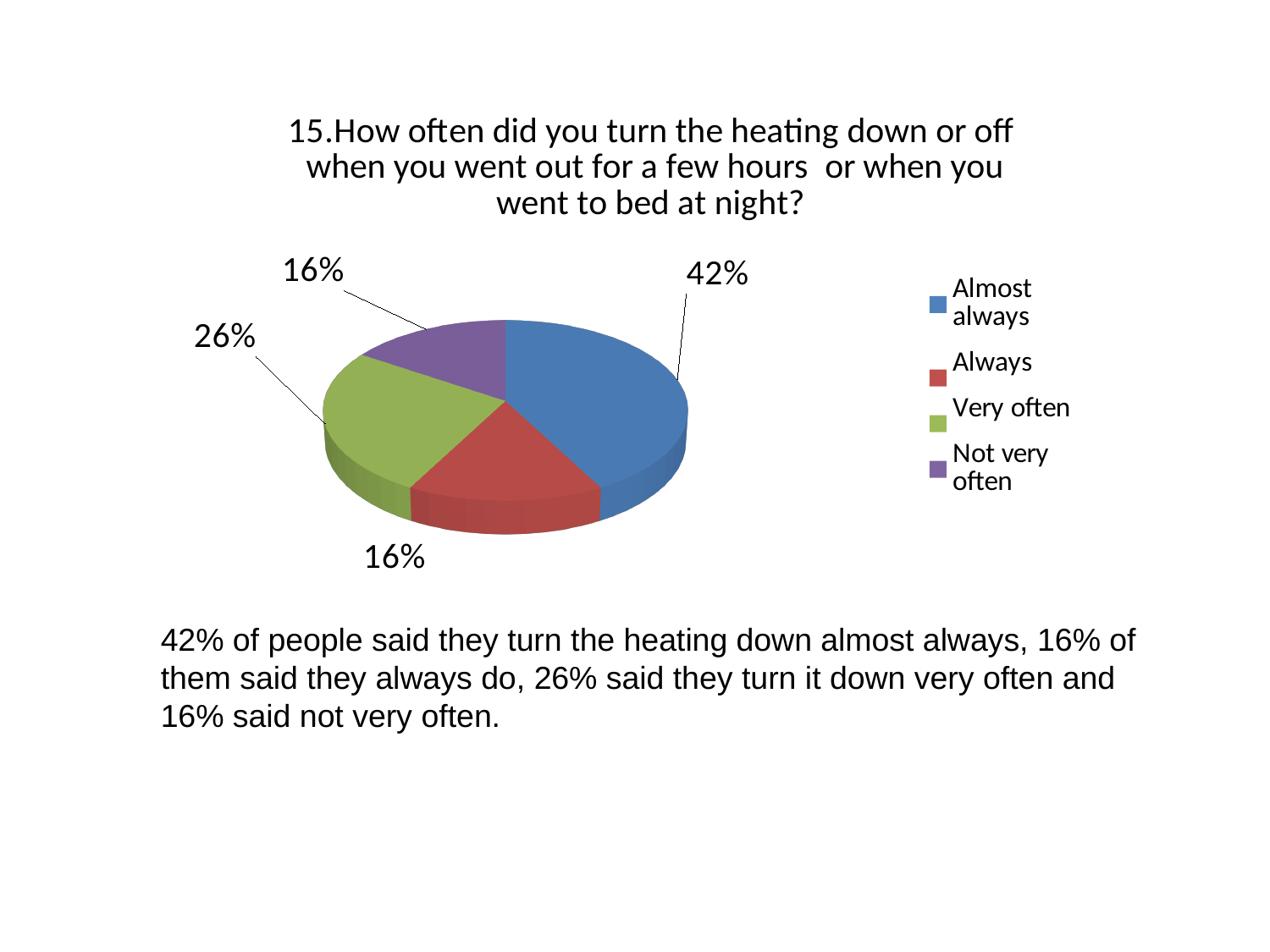
What percentage of respondents answered "Very often"? 26% What percentage of respondents answered "Not very often"? 16% What type of chart is shown on the slide? Pie chart Which is larger, the share for "Very often" or the share for "Always"? Very often Which response category has the largest share of the pie? Almost always What colour represents "Very often" in the chart? Green How many categories does the legend list? 4 What is the difference in percentage points between "Almost always" and "Very often"? 16 What percentage of respondents answered "Always"? 16% What percentage of respondents answered "Almost always"? 42% Is the share for "Almost always" greater or less than 40%? greater What is the combined share of "Almost always" and "Always"? 58%